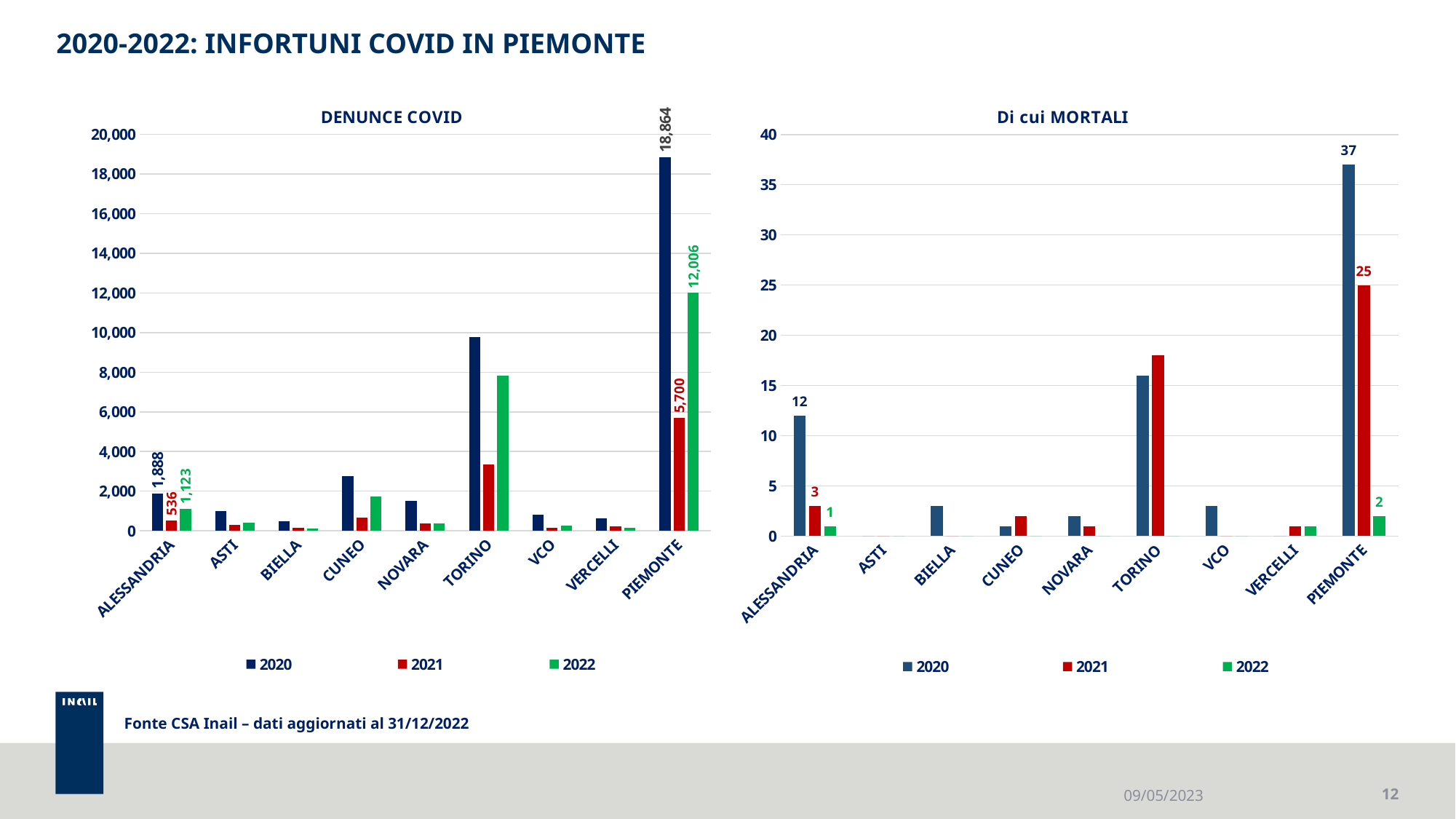
In the Di cui MORTALI chart, is the 2021 value for TORINO greater or less than 15? greater How many categories are shown on the x axis of the DENUNCE COVID chart? 9 In the Di cui MORTALI chart, what is the 2021 value for PIEMONTE? 25 In the DENUNCE COVID chart, what is the 2021 value for ALESSANDRIA? 536 In the DENUNCE COVID chart, what is the difference between the 2022 and 2021 values for PIEMONTE? 6,306 What kind of chart is the Di cui MORTALI chart? bar chart How many series does the legend of the Di cui MORTALI chart list? 3 In the DENUNCE COVID chart, is the 2020 value for TORINO greater or less than 8,000? greater In the Di cui MORTALI chart, what is the difference between the 2020 and 2021 values for ALESSANDRIA? 9 In the Di cui MORTALI chart, which category has the highest 2020 value? PIEMONTE In the DENUNCE COVID chart, what is the 2020 value for PIEMONTE? 18,864 In the DENUNCE COVID chart, which is larger: the 2020 value for CUNEO or the 2020 value for NOVARA? CUNEO